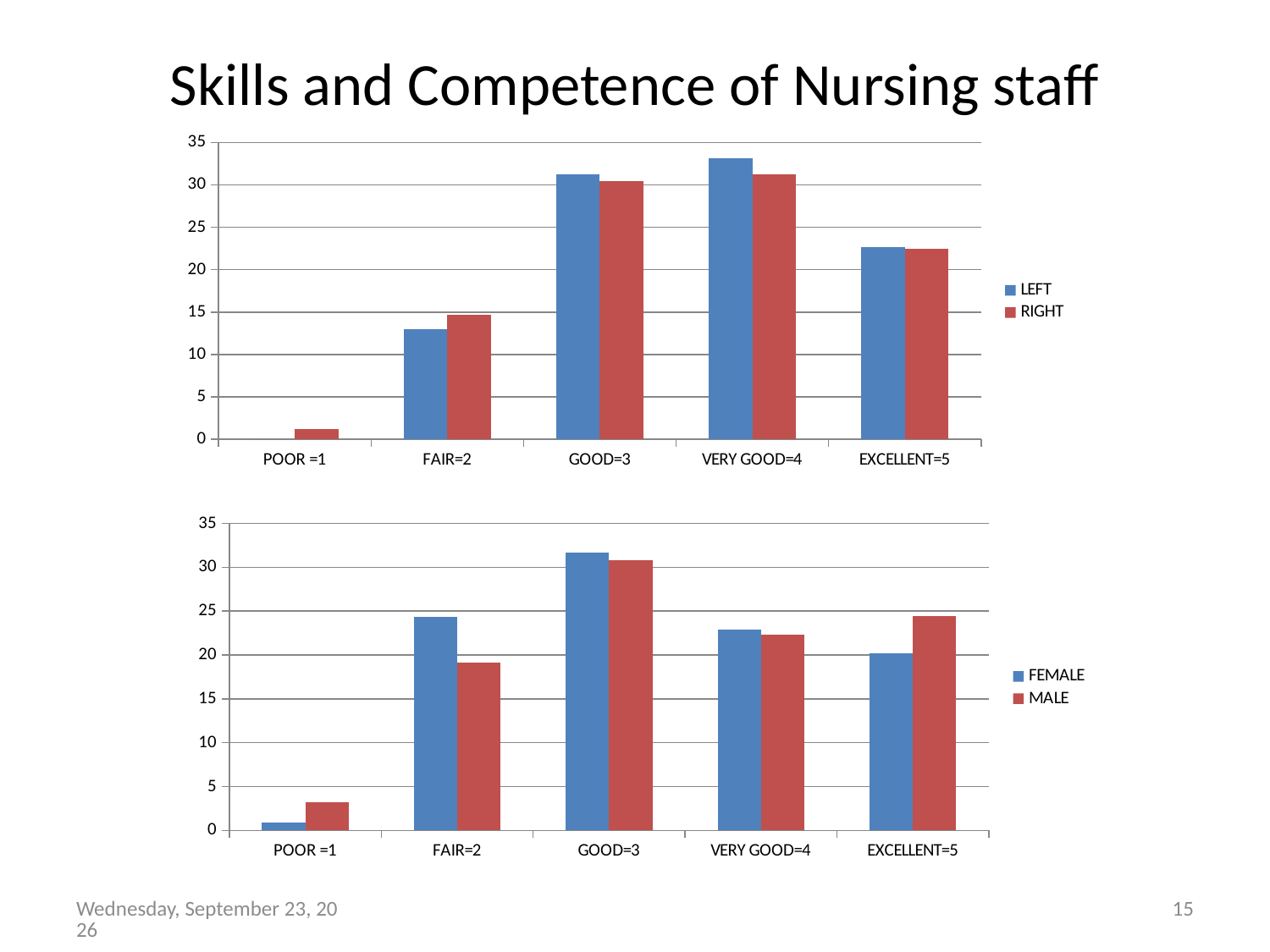
In the bottom chart, which category has the lowest MALE value? POOR =1 In the bottom chart, is the MALE value for FAIR=2 greater or less than 20? less In the bottom chart, which is larger for FAIR=2, the FEMALE value or the MALE value? FEMALE In the bottom chart, which is larger for EXCELLENT=5, the FEMALE value or the MALE value? MALE What are the two legend entries of the top chart? LEFT and RIGHT In the bottom chart, which category has the highest FEMALE value? GOOD=3 How many series does the legend of the bottom chart list? 2 In the top chart, is the LEFT value for GOOD=3 greater or less than 30? greater How many categories are shown on the x axis of the top chart? 5 In the top chart, which category has the lowest RIGHT value? POOR =1 In the top chart, which category has the highest LEFT value? VERY GOOD=4 What kind of chart is the top chart on the slide? bar chart